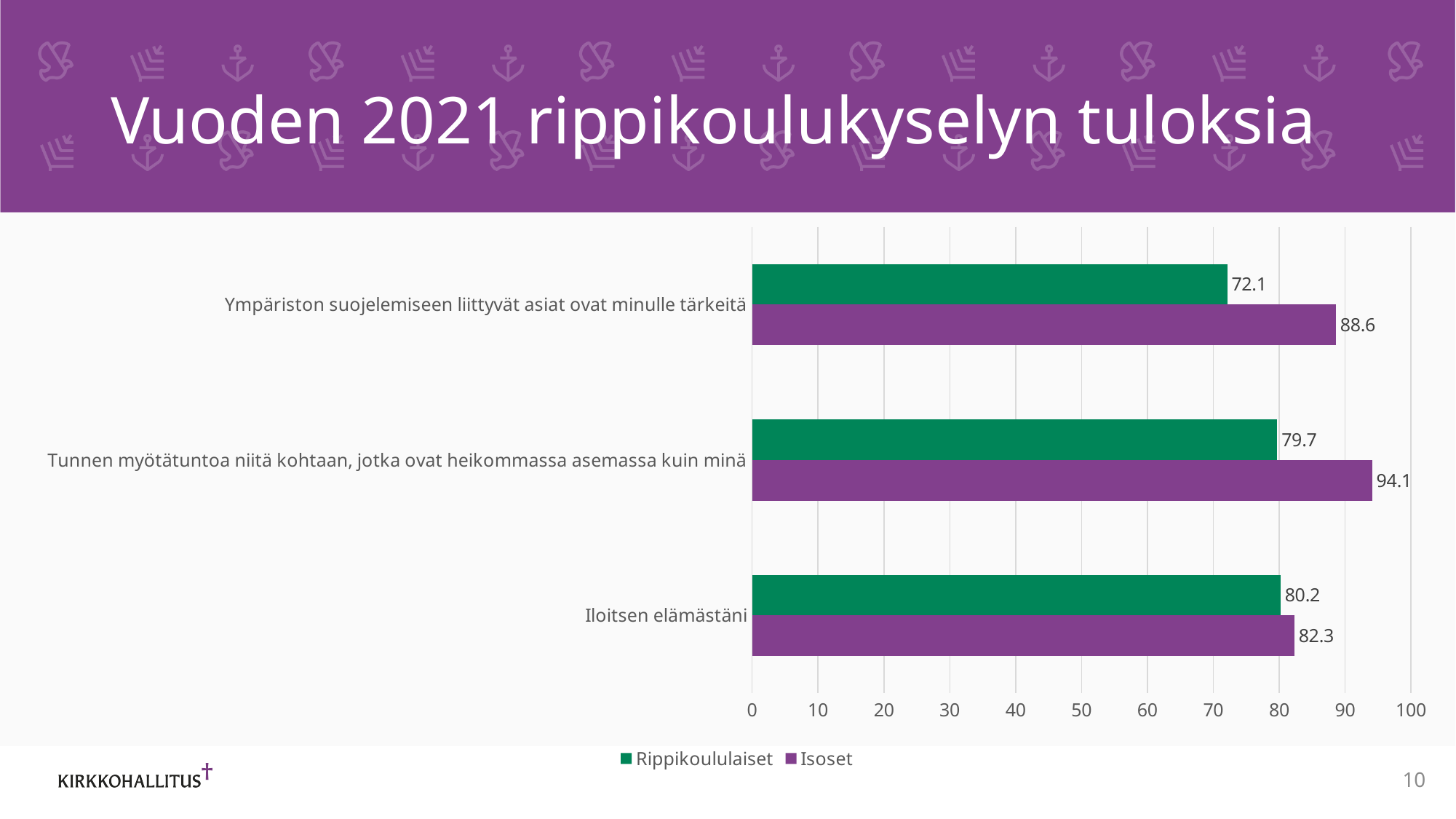
What is the value for Isoset for "Iloitsen elämästäni"? 82.3 What kind of chart is shown on the slide? Bar chart Is the Isoset value for "Ympäriston suojelemiseen liittyvät asiat ovat minulle tärkeitä" greater or less than 80? greater How many categories are shown in the chart? 3 What is the value for Isoset for "Tunnen myötätuntoa niitä kohtaan, jotka ovat heikommassa asemassa kuin minä"? 94.1 Which category has the lowest value for Rippikoululaiset? Ympäriston suojelemiseen liittyvät asiat ovat minulle tärkeitä What is the difference between the Isoset and Rippikoululaiset values for "Ympäriston suojelemiseen liittyvät asiat ovat minulle tärkeitä"? 16.5 Which category has the highest value for Isoset? Tunnen myötätuntoa niitä kohtaan, jotka ovat heikommassa asemassa kuin minä Which series has the larger value for "Tunnen myötätuntoa niitä kohtaan, jotka ovat heikommassa asemassa kuin minä"? Isoset What is the value for Rippikoululaiset for "Ympäriston suojelemiseen liittyvät asiat ovat minulle tärkeitä"? 72.1 What is the difference between the Isoset and Rippikoululaiset values for "Iloitsen elämästäni"? 2.1 How many series does the legend list? 2